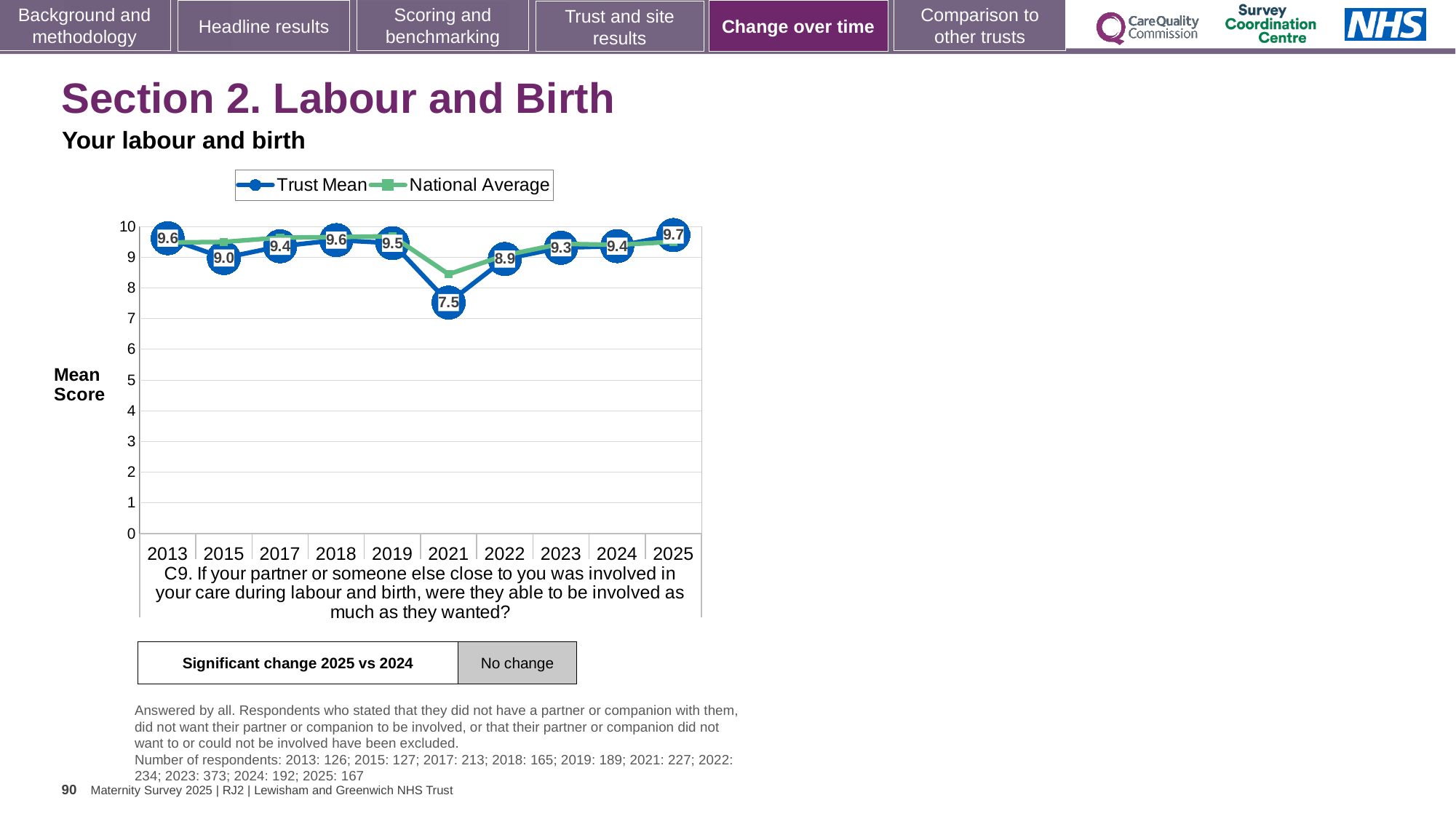
Which year has the larger Trust Mean, 2019 or 2022? 2019 What is the difference between the Trust Mean in 2025 and in 2024? 0.3 In which year is the Trust Mean highest? 2025 Is the National Average value for 2021 greater or less than 9? less In which year is the Trust Mean lowest? 2021 Does the Trust Mean rise or fall from 2021 to 2025? rise What is the Trust Mean value for 2025? 9.7 How many years are plotted on the x axis? 10 How many series does the legend list? 2 What is the Trust Mean value for 2021? 7.5 What kind of chart is shown on the slide? line chart What is the Trust Mean value for 2015? 9.0